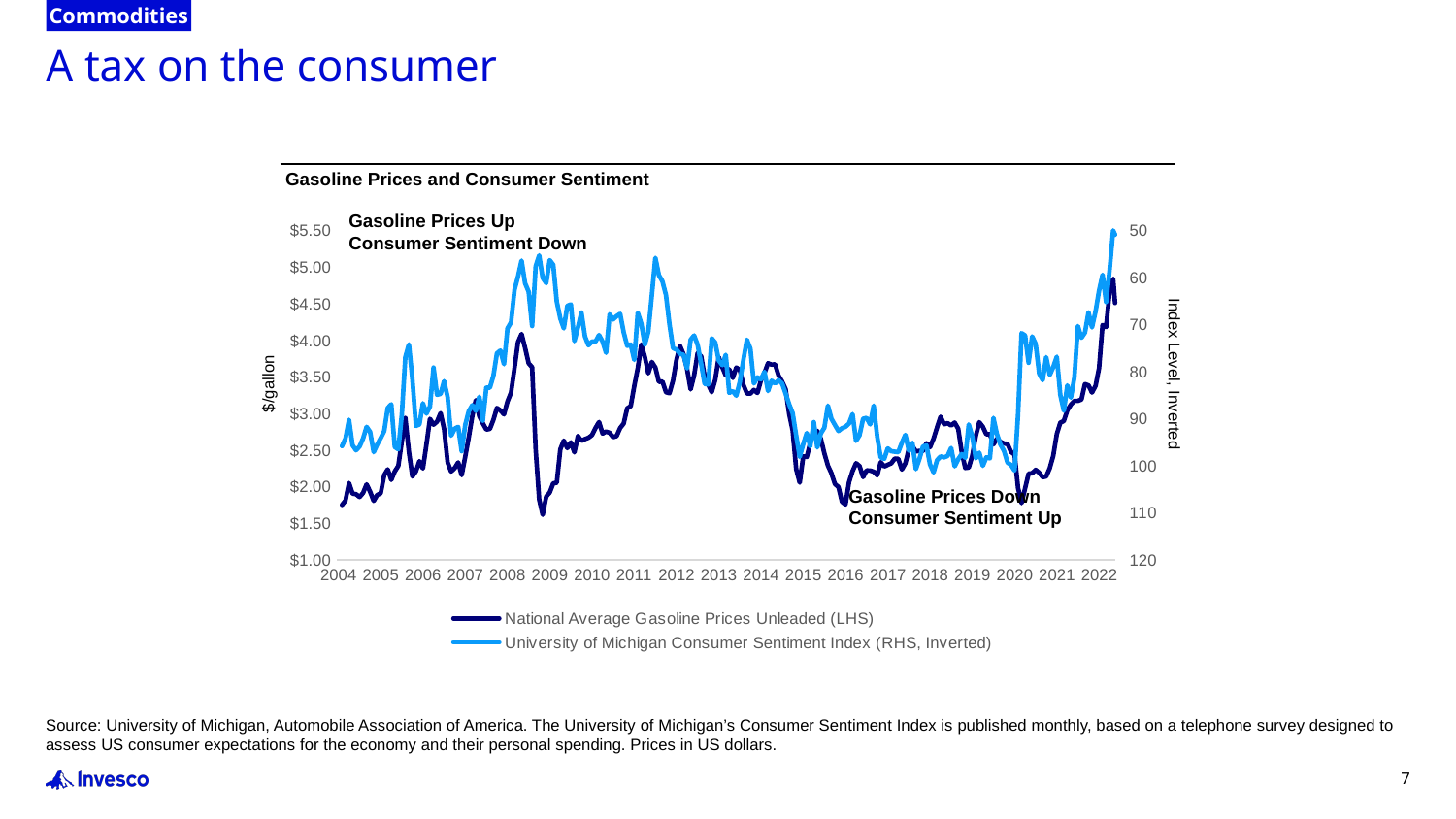
Is the National Average Gasoline Price in 2012 greater or less than $3.00? greater What kind of chart is shown on the slide? Line chart Is the lowest National Average Gasoline Price around the end of 2008/start of 2009 greater or less than $2.00? less What is the title of the chart? Gasoline Prices and Consumer Sentiment Do National Average Gasoline Prices rise or fall between 2014 and 2016? fall Is the University of Michigan Consumer Sentiment Index at its 2022 extreme greater or less than 60 on the inverted right-hand axis? less What is the label of the left-hand vertical axis? $/gallon How many year labels are shown along the x axis? 19 Do National Average Gasoline Prices rise or fall between 2020 and 2022? rise How many series does the legend list? 2